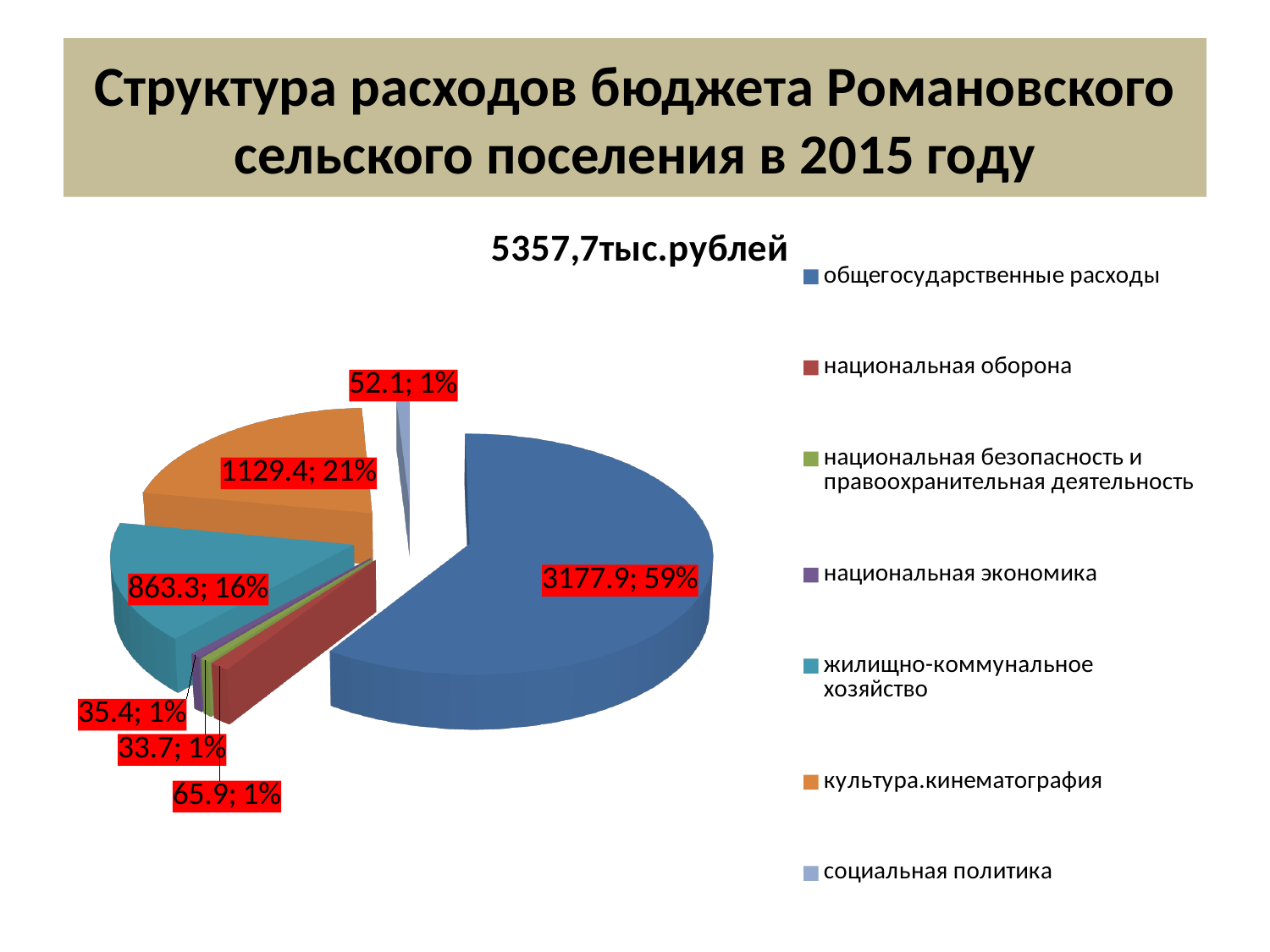
Which category has the largest slice? общегосударственные расходы What type of chart is shown on the slide? pie chart What is the value for социальная политика? 52.1 What share of the pie does жилищно-коммунальное хозяйство take? 16% Which is larger, the value for национальная оборона or the value for национальная экономика? национальная оборона How many categories does the legend list? 7 What is the difference between the values for культура.кинематография and жилищно-коммунальное хозяйство? 266.1 What is the value for общегосударственные расходы? 3177.9 What is the value for культура.кинематография? 1129.4 What is the title shown above the pie chart? 5357,7тыс.рублей Which category has the smallest value? национальная безопасность и правоохранительная деятельность What share of the pie does общегосударственные расходы take? 59%